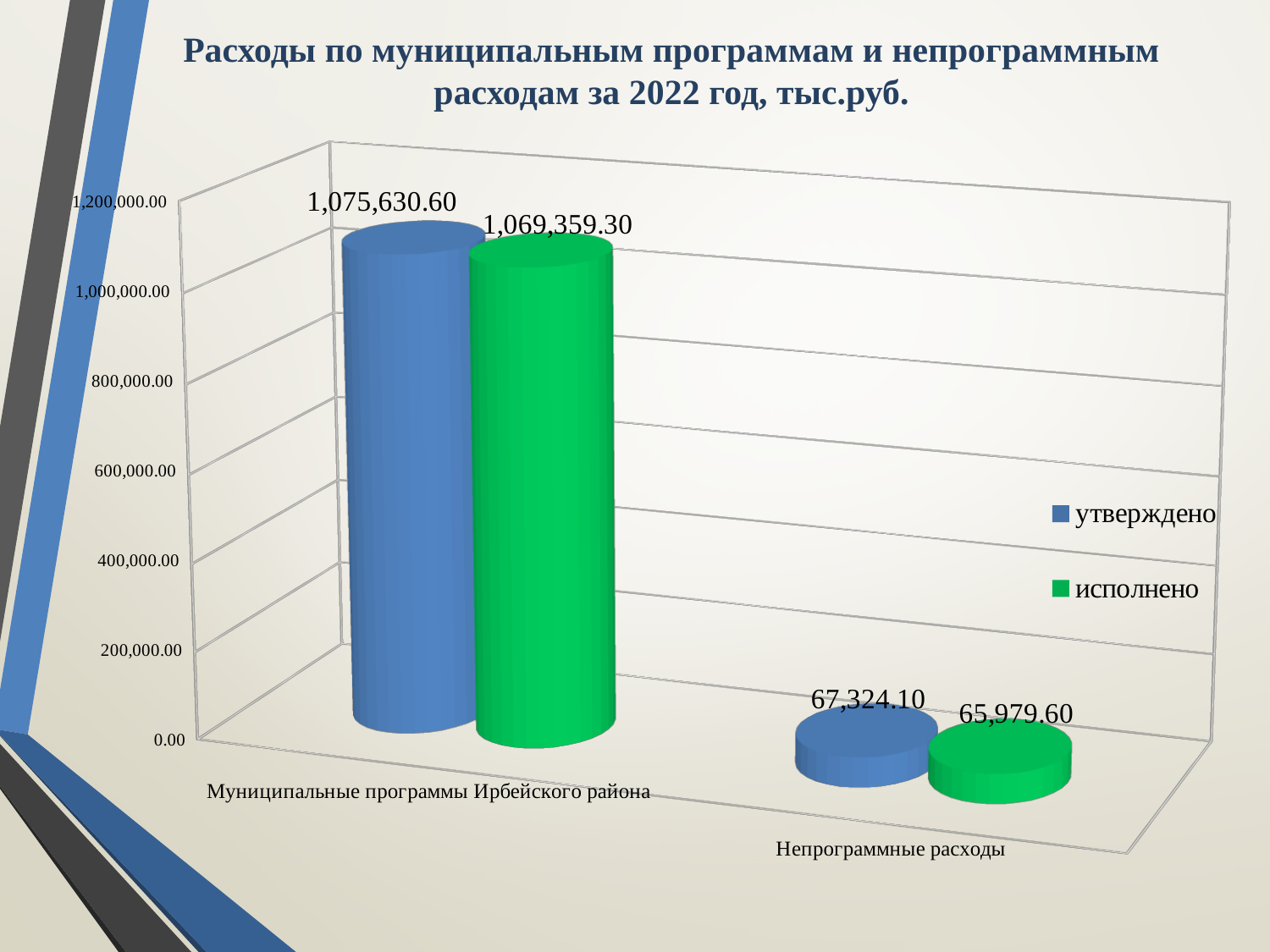
What is the исполнено value for Непрограммные расходы? 65,979.60 Is the исполнено value for Муниципальные программы Ирбейского района greater or less than 1,000,000.00? greater Which category has the highest утверждено value? Муниципальные программы Ирбейского района How many series does the legend list? 2 What kind of chart is shown on the slide? bar chart For Непрограммные расходы, which is larger: утверждено or исполнено? утверждено What is the difference between the утверждено and исполнено values for Муниципальные программы Ирбейского района? 6,271.30 Which category has the lowest исполнено value? Непрограммные расходы What is the утверждено value for Муниципальные программы Ирбейского района? 1,075,630.60 What is the исполнено value for Муниципальные программы Ирбейского района? 1,069,359.30 What is the утверждено value for Непрограммные расходы? 67,324.10 What is the difference between the утверждено and исполнено values for Непрограммные расходы? 1,344.50